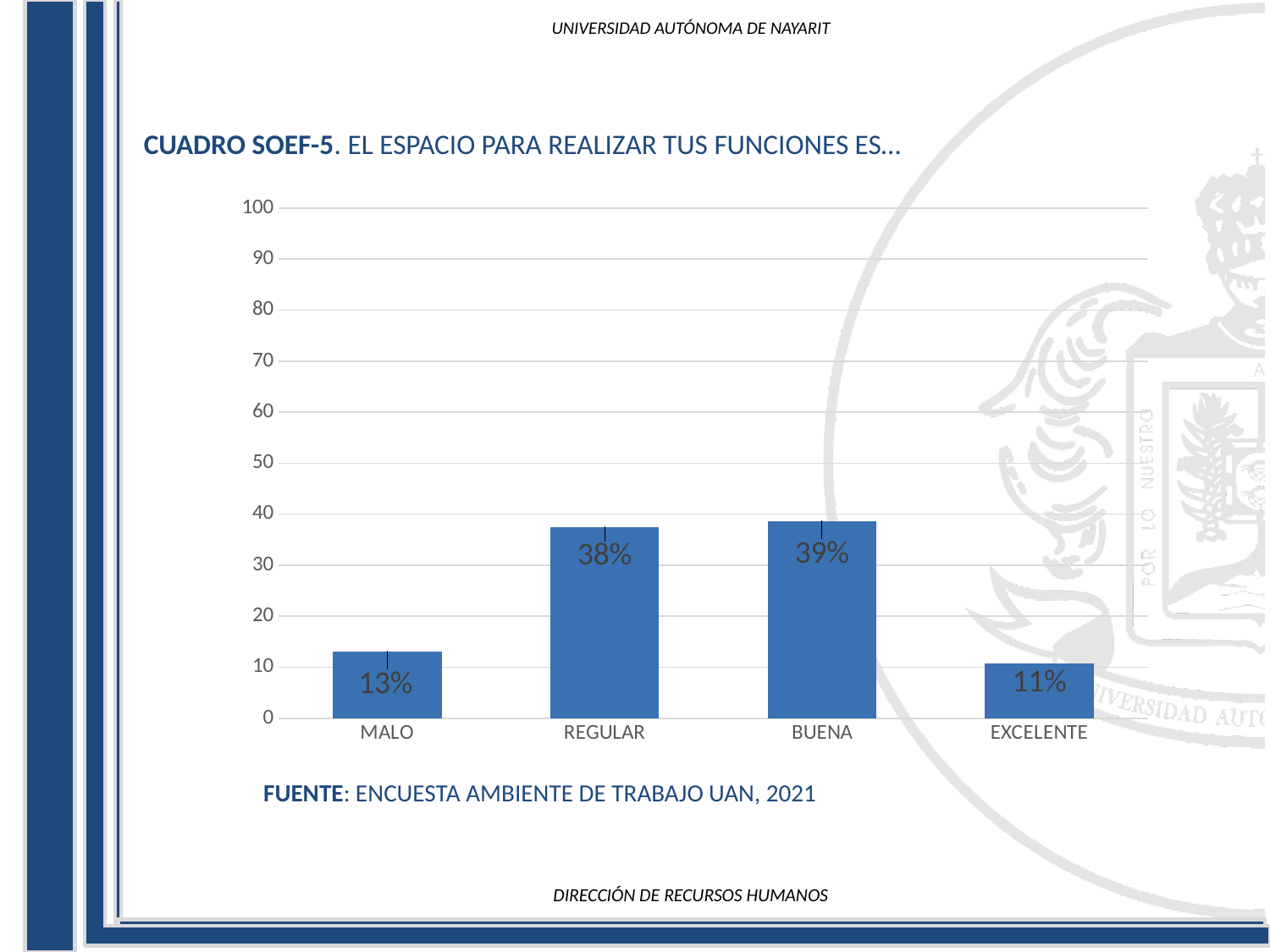
Which is larger, the value for REGULAR or the value for EXCELENTE? REGULAR What is the value for EXCELENTE? 11% What kind of chart is shown on the slide? bar chart How many categories are shown on the x axis? 4 What is the value for MALO? 13% Which category has the lowest value? EXCELENTE Is the value for BUENA greater or less than 30? greater Which category has the highest value? BUENA What is the difference between the values for MALO and EXCELENTE? 2% What is the difference between the values for BUENA and MALO? 26% What is the value for REGULAR? 38% What source is cited below the chart? ENCUESTA AMBIENTE DE TRABAJO UAN, 2021